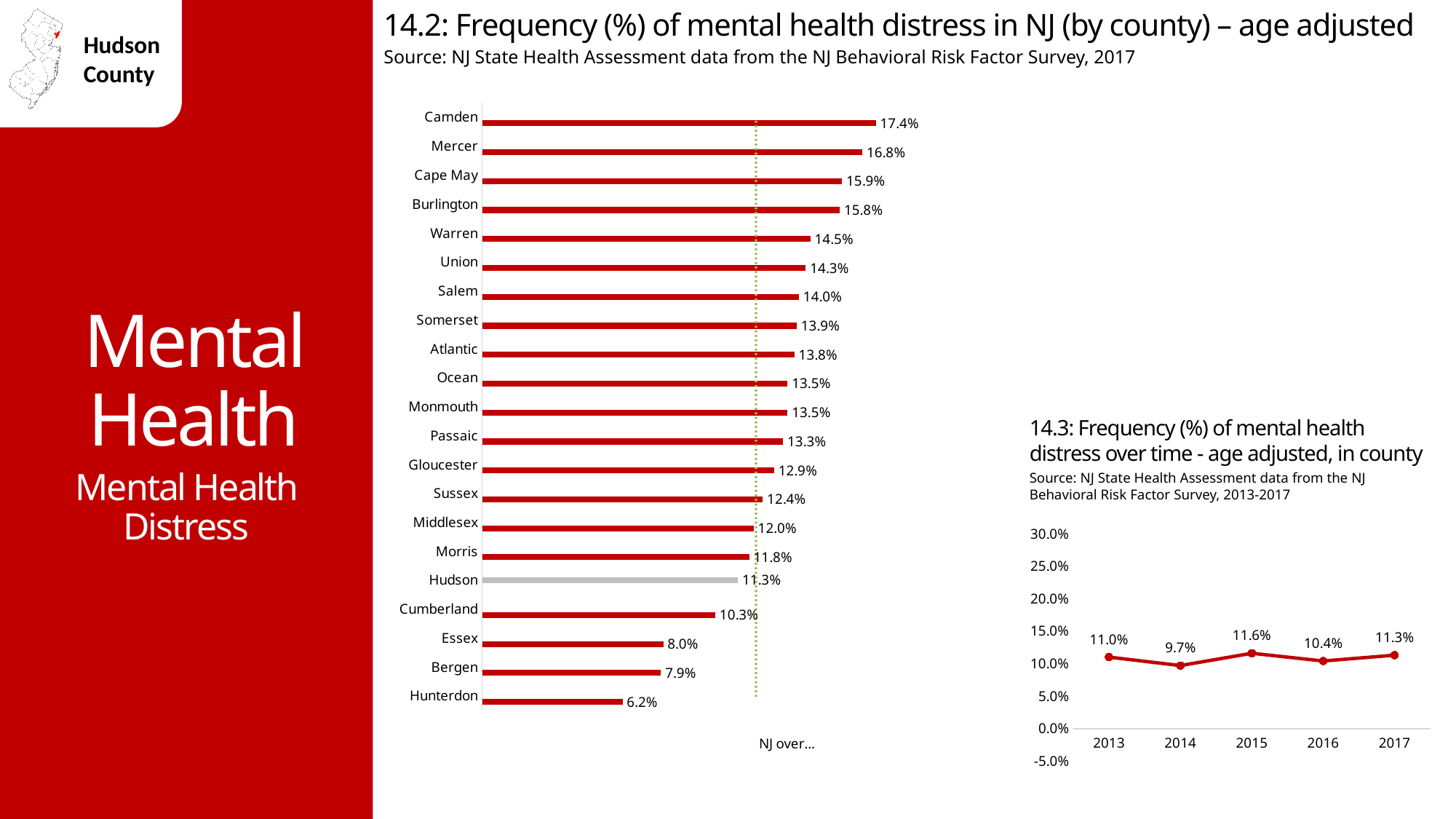
In the chart 14.3 (over time), what is the value for 2014? 9.7% In the chart 14.2 (by county), which is larger, the value for Mercer or the value for Cape May? Mercer In the chart 14.2 (by county), which county has the lowest value? Hunterdon In the chart 14.3 (over time), what is the difference between 2015 and 2016? 1.2% In the chart 14.2 (by county), which county has the highest value? Camden In the chart 14.2 (by county), what is the value for Cumberland? 10.3% In the chart 14.3 (over time), which year has the highest value? 2015 In the chart 14.2 (by county), what is the value for Hudson? 11.3% In the chart 14.2 (by county), how many counties are plotted? 21 What kind of chart is chart 14.2 (by county)? Bar chart In the chart 14.2 (by county), which bar is shown in grey rather than red? Hudson In the chart 14.2 (by county), what is the difference between Camden and Hunterdon? 11.2%